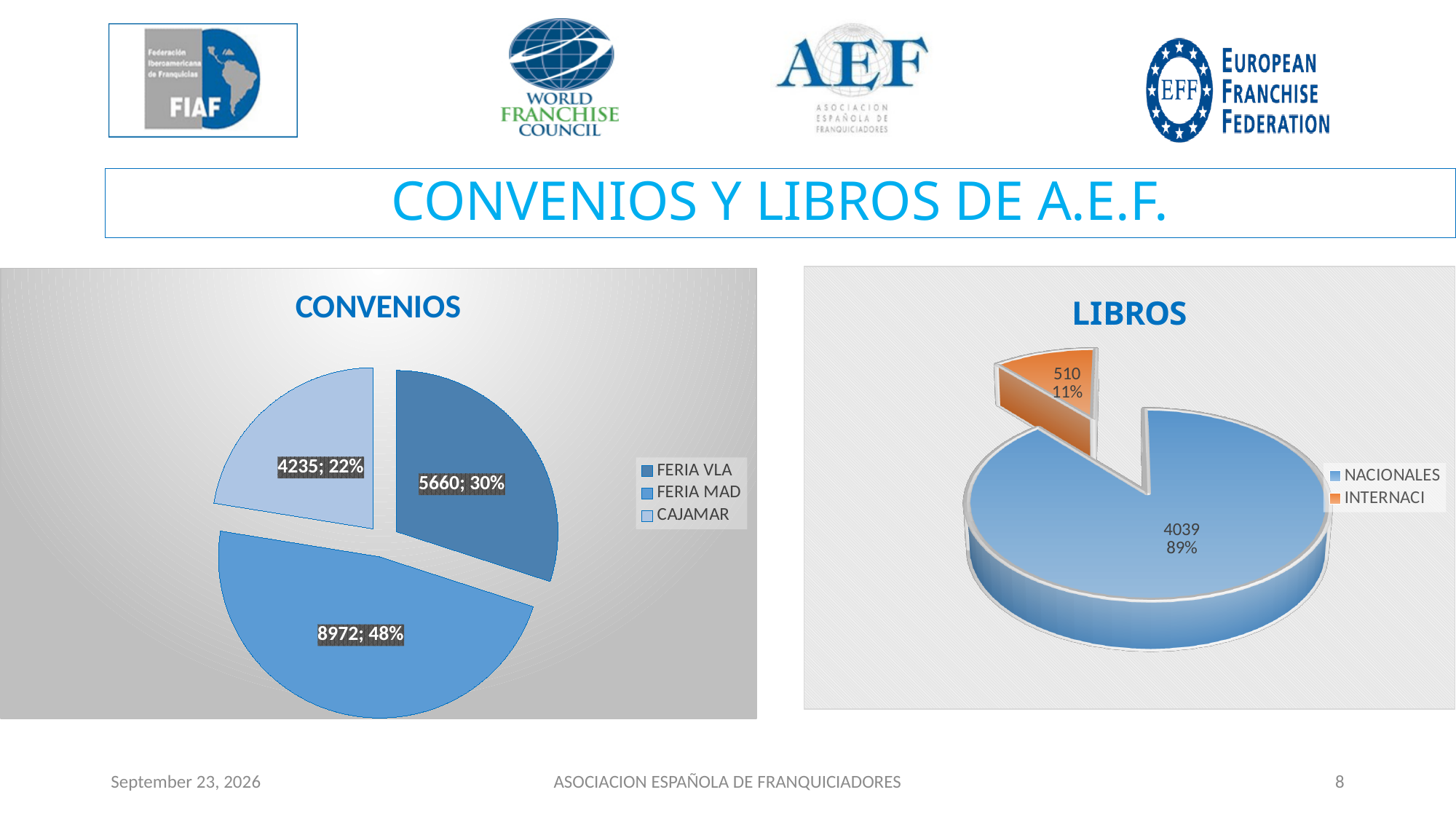
In the CONVENIOS chart, which category has the smallest slice? CAJAMAR In the LIBROS chart, what colour is the INTERNACI slice? Orange In the CONVENIOS chart, what value is shown for FERIA MAD? 8972 In the LIBROS chart, what value is shown for NACIONALES? 4039 In the CONVENIOS chart, which category has the largest slice? FERIA MAD In the CONVENIOS chart, what is the difference between the FERIA VLA and CAJAMAR values? 1425 In the CONVENIOS chart, what percentage share does CAJAMAR have? 22% In the LIBROS chart, which is larger, NACIONALES or INTERNACI? NACIONALES What kind of chart is the LIBROS chart? Pie chart In the LIBROS chart, what is the total of the two slices? 4549 In the LIBROS chart, what percentage share does INTERNACI have? 11% In the CONVENIOS chart, how many categories are shown? 3